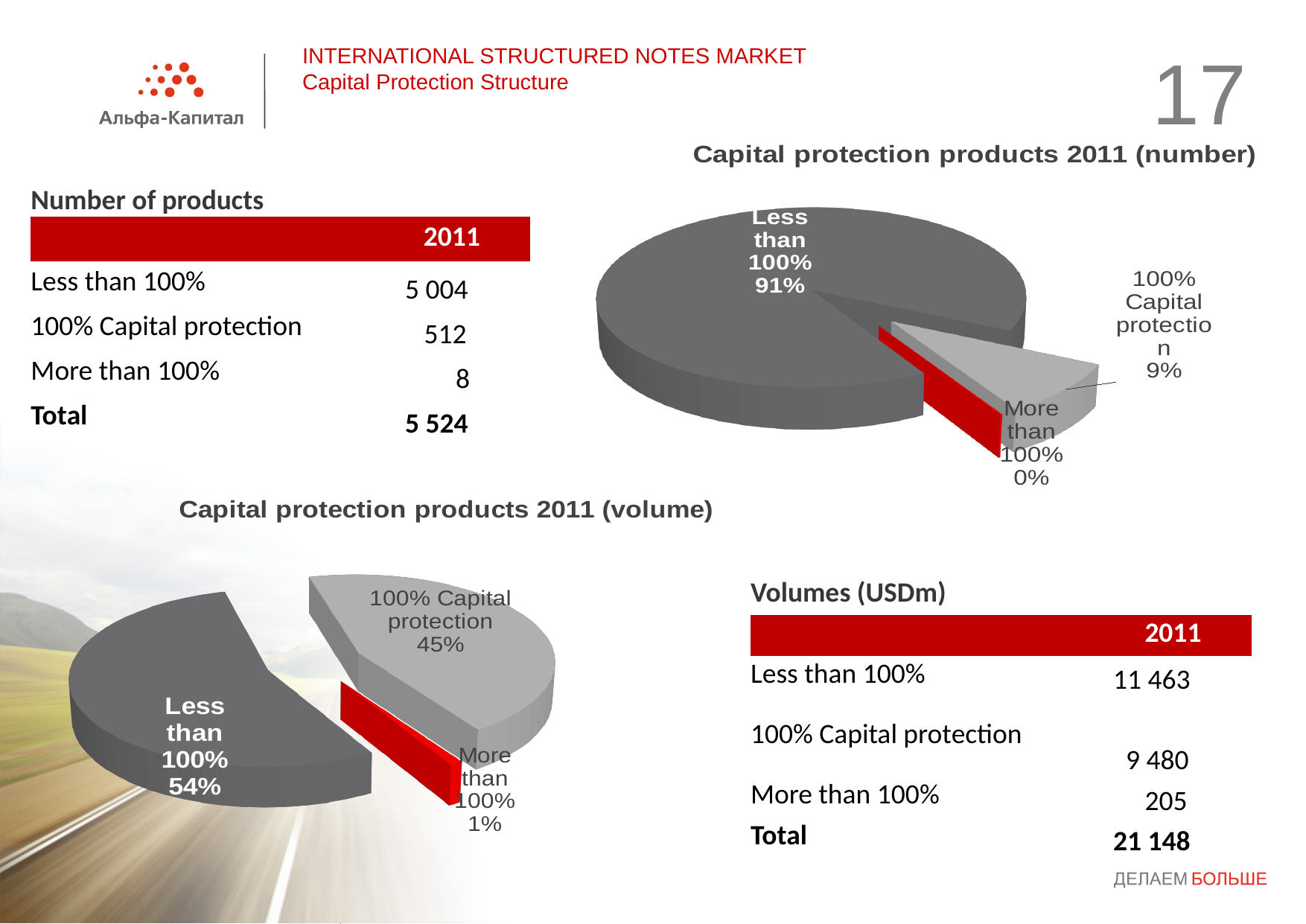
In the 'Capital protection products 2011 (volume)' chart, what share does 'More than 100%' have? 1% In the 'Capital protection products 2011 (volume)' chart, what share does '100% Capital protection' have? 45% What kind of chart is 'Capital protection products 2011 (number)'? Pie chart In the 'Capital protection products 2011 (number)' chart, what share does '100% Capital protection' have? 9% How many slices does the 'Capital protection products 2011 (volume)' chart have? 3 In the 'Capital protection products 2011 (volume)' chart, which is larger: 'Less than 100%' or '100% Capital protection'? Less than 100% In the 'Capital protection products 2011 (volume)' chart, what is the difference in share between 'Less than 100%' and '100% Capital protection'? 9% In the 'Capital protection products 2011 (number)' chart, which category has the largest slice? Less than 100% In the 'Capital protection products 2011 (number)' chart, which category has the smallest slice? More than 100%